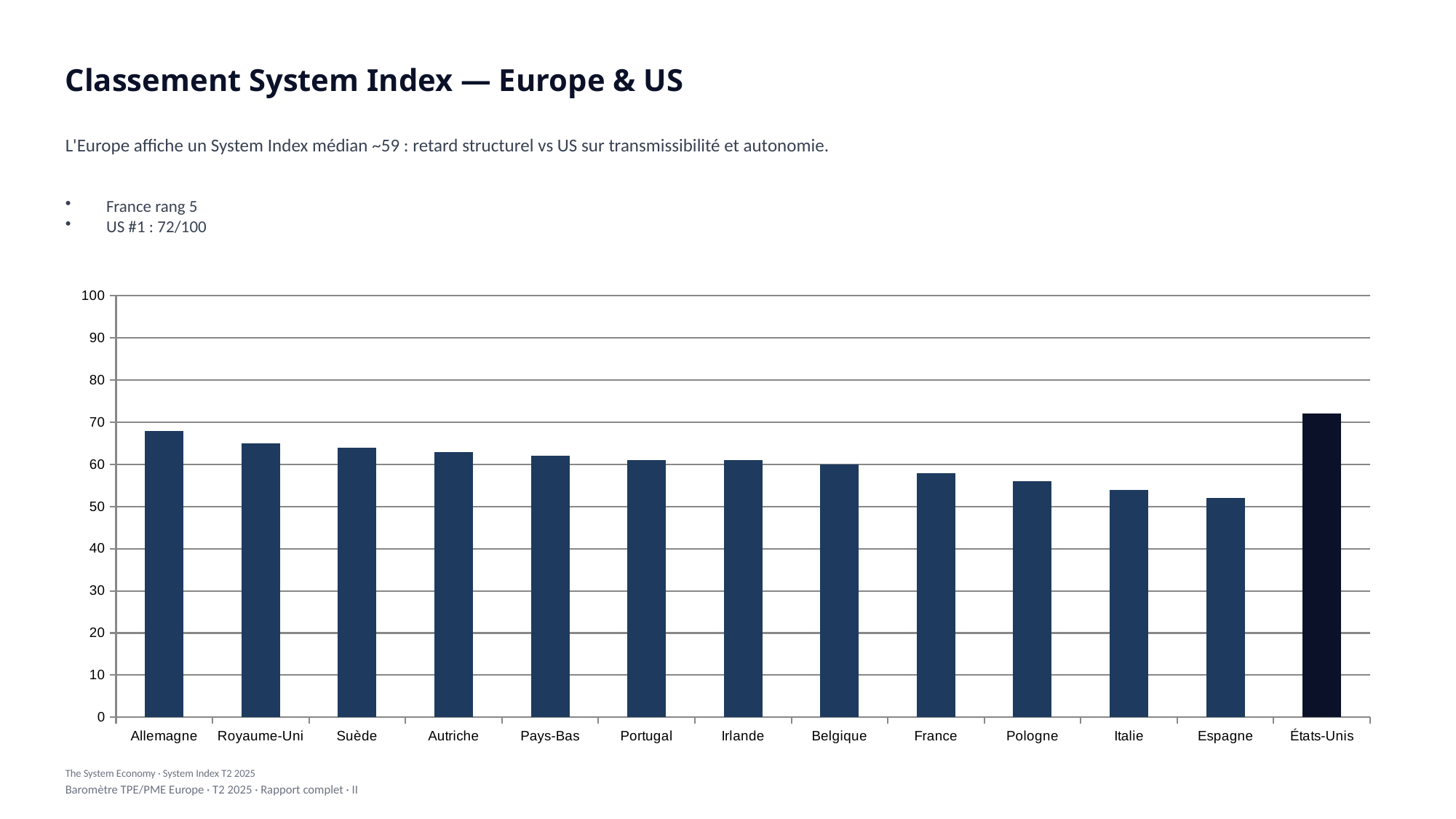
Which country has the highest bar in the chart? États-Unis Is the value for Espagne greater or less than 60? less Which has the larger value, Allemagne or Espagne? Allemagne What kind of chart is shown on the slide? bar chart Is the value for Pologne greater or less than 60? less Do the values for the European countries, from Allemagne to Espagne, rise or fall from left to right? fall Is the value for Allemagne greater or less than 60? greater How many countries are shown on the x axis of the chart? 13 Which country has the lowest bar in the chart? Espagne Which country's bar is drawn in a darker colour than the others? États-Unis Which has the larger value, Royaume-Uni or Italie? Royaume-Uni